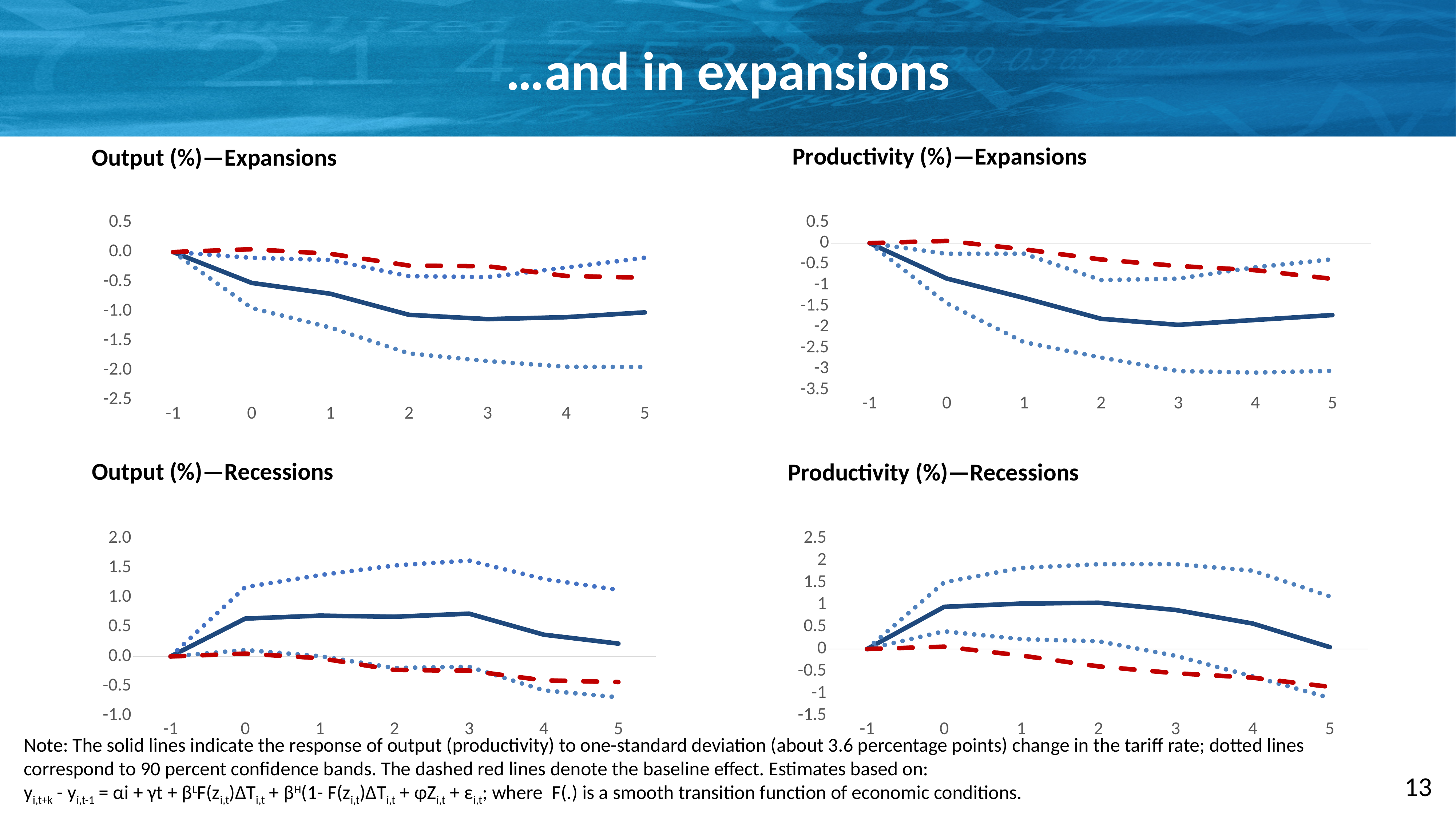
According to the note, what do the dashed red lines denote? the baseline effect In the "Output (%)—Recessions" chart, is the solid line higher at 3 or at 5? 3 In the "Output (%)—Recessions" chart, is the solid line's value at 3 greater or less than 0.5? greater In the "Productivity (%)—Recessions" chart, does the solid line rise or fall from 3 to 5 on the x axis? falls In the "Output (%)—Expansions" chart, does the solid line rise or fall from -1 to 3 on the x axis? falls In the "Productivity (%)—Recessions" chart, is the solid line's value at 5 greater or less than 0.5? less In the "Productivity (%)—Expansions" chart, is the solid line's value at 3 greater or less than -1.5? less What is the title of the top-right chart? Productivity (%)—Expansions In the "Output (%)—Expansions" chart, how many points are on the x axis? 7 What kind of chart is "Output (%)—Expansions"? line chart